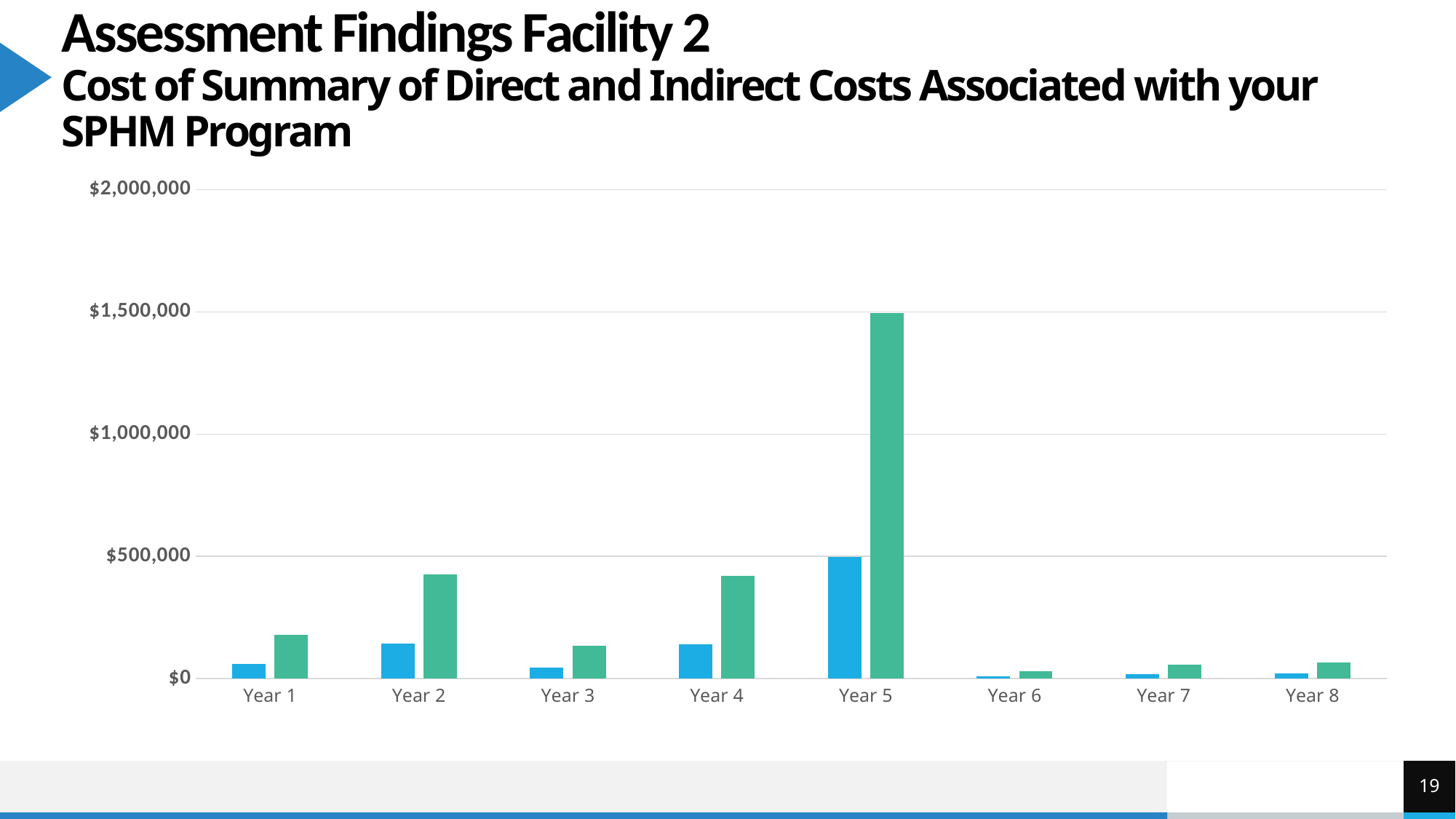
Is the value of the blue bar for Year 1 greater or less than $500,000? less What kind of chart is shown on the slide? bar chart Which year has the tallest blue bar? Year 5 What is the highest value labelled on the vertical axis? $2,000,000 Is the value of the green bar for Year 2 greater or less than $500,000? less Is the value of the green bar for Year 5 greater or less than $1,000,000? greater In Year 5, which bar is taller, the blue bar or the green bar? the green bar How many year categories are shown on the x axis? 8 Which year has the tallest bar in the chart? Year 5 Which is taller, the green bar for Year 2 or the green bar for Year 6? Year 2 How many differently coloured bar series are plotted for each year? 2